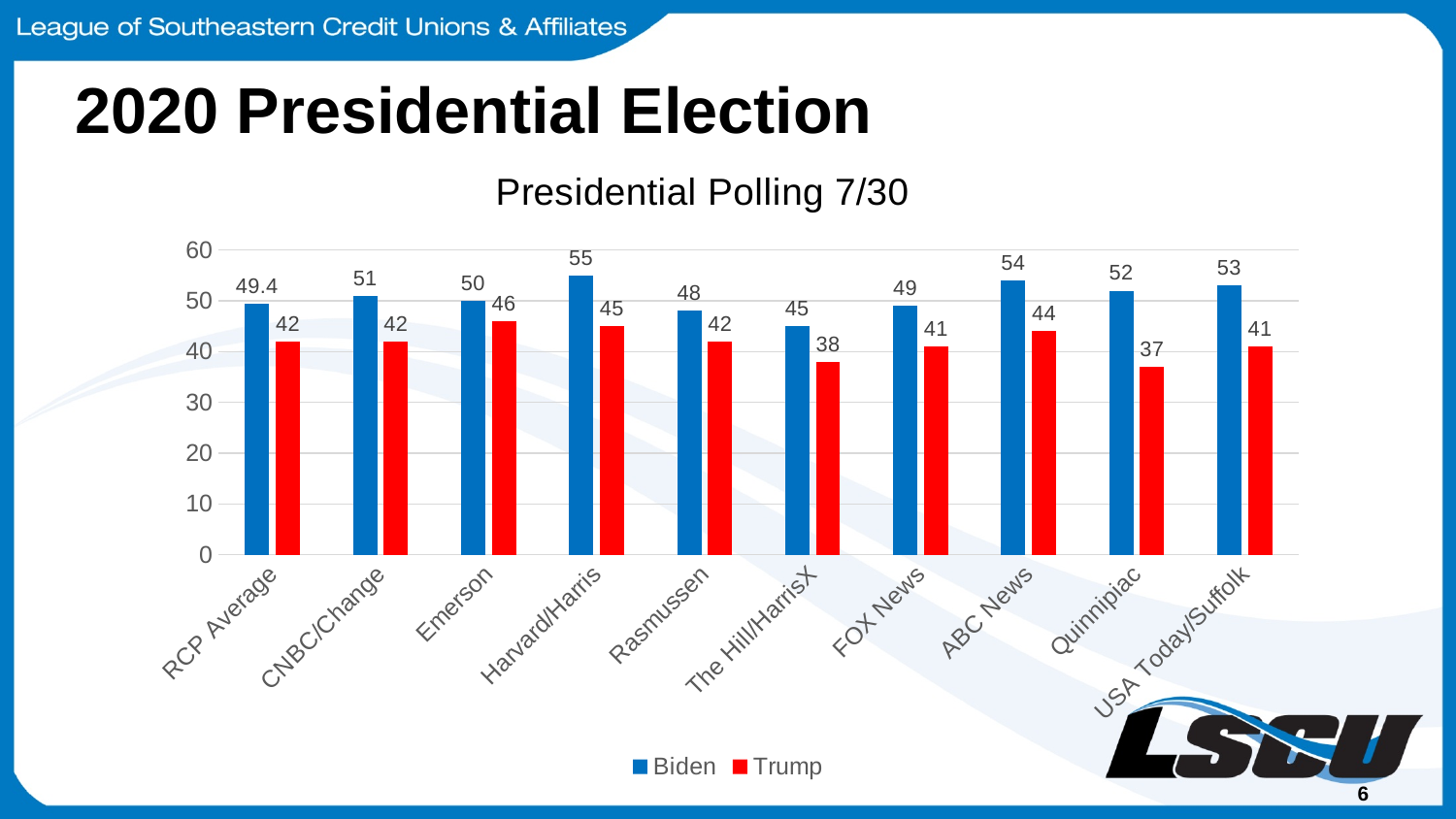
Which poll shows the highest Biden value? Harvard/Harris What is the Trump value for Quinnipiac? 37 What is the Biden value for Harvard/Harris? 55 Which is larger, the Trump value for Emerson or the Trump value for FOX News? Emerson What is the difference between the Biden and Trump values for ABC News? 10 How many polls are shown on the x axis? 10 Which poll shows the lowest Trump value? Quinnipiac What kind of chart is shown? bar chart Is the Trump value for The Hill/HarrisX greater or less than 40? less How many series does the legend list? 2 What is the title of the chart? Presidential Polling 7/30 What is the Biden value for RCP Average? 49.4